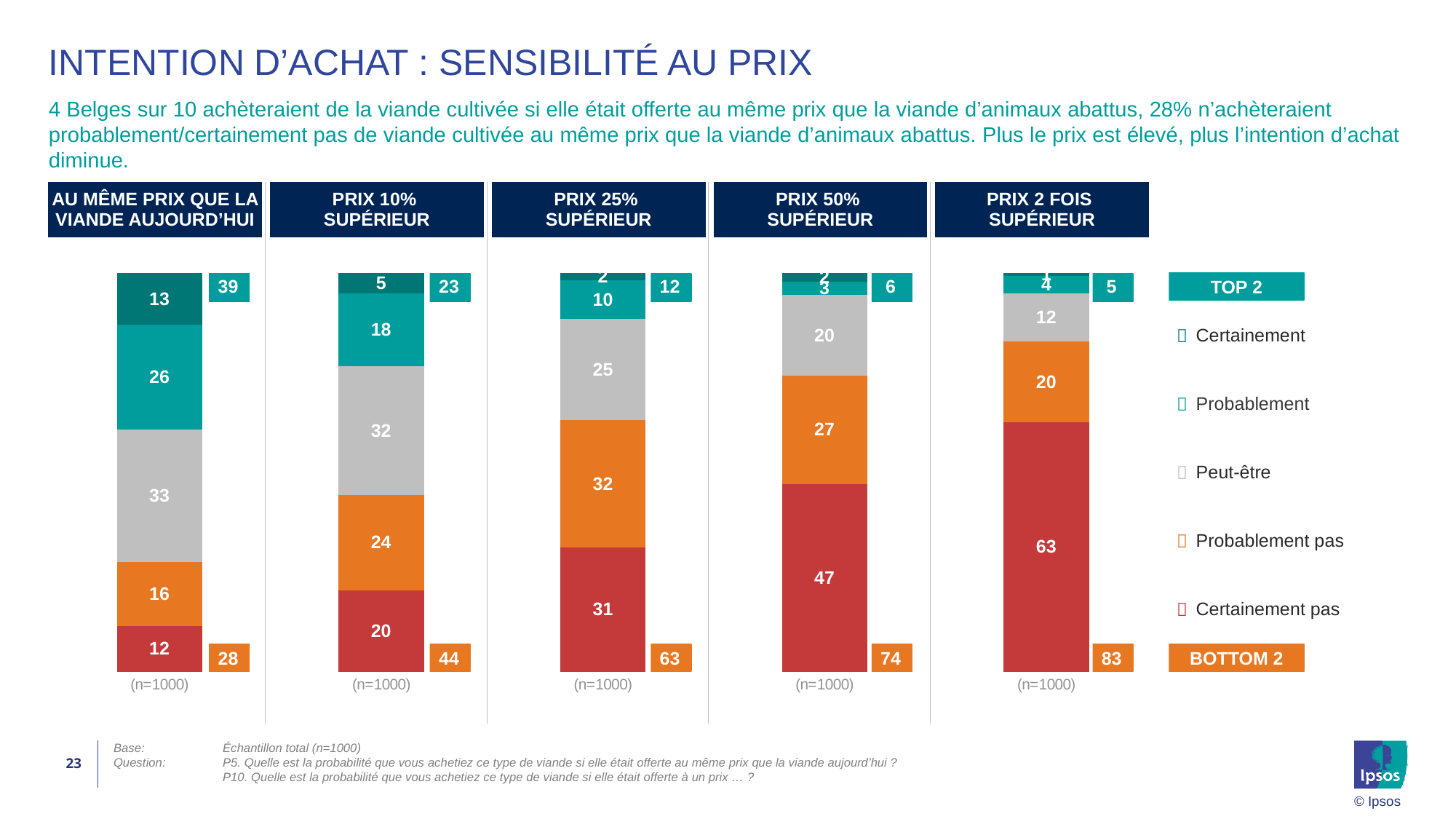
In the chart titled 'PRIX 10% SUPÉRIEUR', what is the difference between the 'Peut-être' value and the 'Certainement pas' value? 12 Moving from the same-price chart to the 'PRIX 2 FOIS SUPÉRIEUR' chart, does the BOTTOM 2 value rise or fall? Rise In the chart titled 'PRIX 10% SUPÉRIEUR', what is the value for 'Probablement pas'? 24 In the chart titled 'AU MÊME PRIX QUE LA VIANDE AUJOURD'HUI', what is the value for 'Peut-être'? 33 How many response categories does the legend list (excluding TOP 2 and BOTTOM 2)? 5 Which chart has the higher TOP 2 value: 'PRIX 25% SUPÉRIEUR' or 'PRIX 50% SUPÉRIEUR'? PRIX 25% SUPÉRIEUR In the chart titled 'AU MÊME PRIX QUE LA VIANDE AUJOURD'HUI', what is the total of 'Certainement' and 'Probablement' (the TOP 2 value)? 39 In the chart titled 'PRIX 2 FOIS SUPÉRIEUR', what is the BOTTOM 2 value? 83 In the chart titled 'PRIX 50% SUPÉRIEUR', which response category has the largest value? Certainement pas In the chart titled 'AU MÊME PRIX QUE LA VIANDE AUJOURD'HUI', which response category has the smallest value? Certainement pas In the chart titled 'PRIX 25% SUPÉRIEUR', what is the value for 'Certainement pas'? 31 What kind of chart is used on this slide? Stacked bar chart